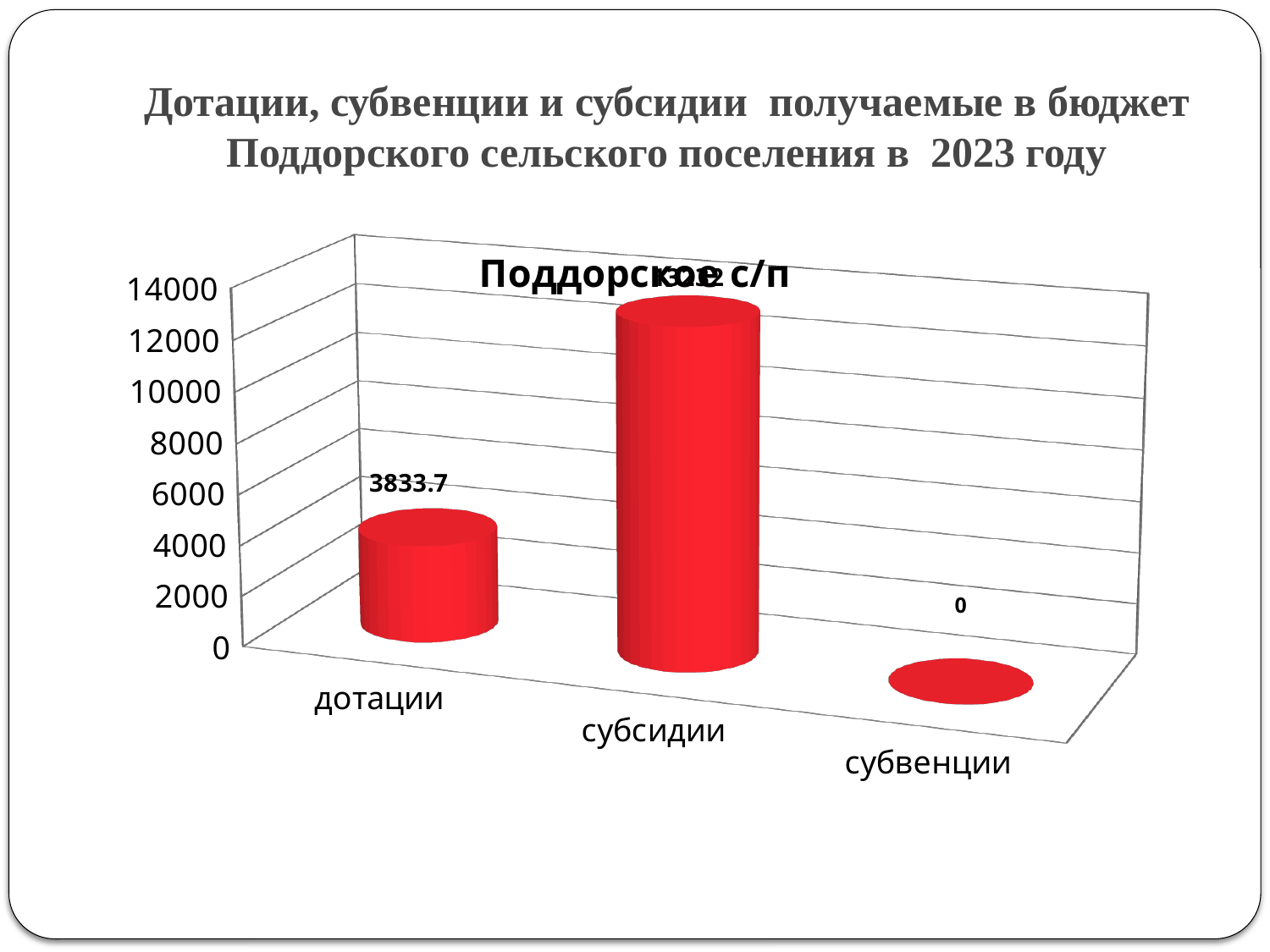
Is the value for субсидии greater or less than 10000? greater What is the title printed inside the chart area? Поддорское с/п Which category has the highest value? субсидии What kind of chart is shown on the slide? bar chart Which is larger, the value for дотации or the value for субсидии? субсидии How many categories are shown on the x axis? 3 What is the value for дотации? 3833.7 Which category has the lowest value? субвенции What is the value for субвенции? 0 Is the value for дотации greater or less than 6000? less What is the difference between the value for дотации and the value for субвенции? 3833.7 What colour are the bars in the chart? red